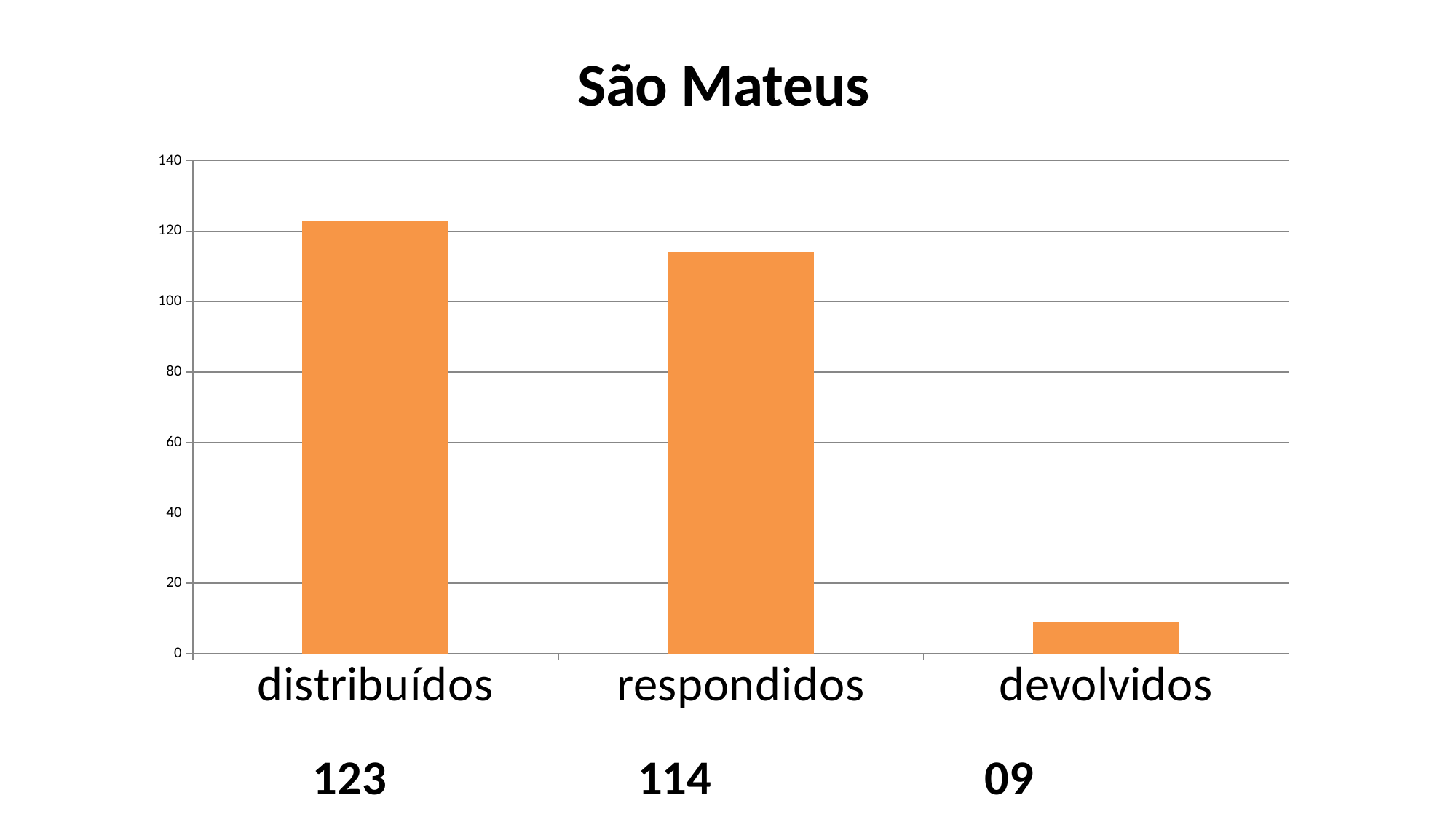
What is the value for devolvidos? 09 What is the title of the chart? São Mateus Is the value for respondidos greater or less than 100? greater What is the value for distribuídos? 123 Which category has the lowest value? devolvidos What is the value for respondidos? 114 What is the difference between respondidos and devolvidos? 105 Which is larger, distribuídos or respondidos? distribuídos What kind of chart is this? bar chart Which category has the highest value? distribuídos How many categories are shown on the chart? 3 What is the difference between distribuídos and respondidos? 9